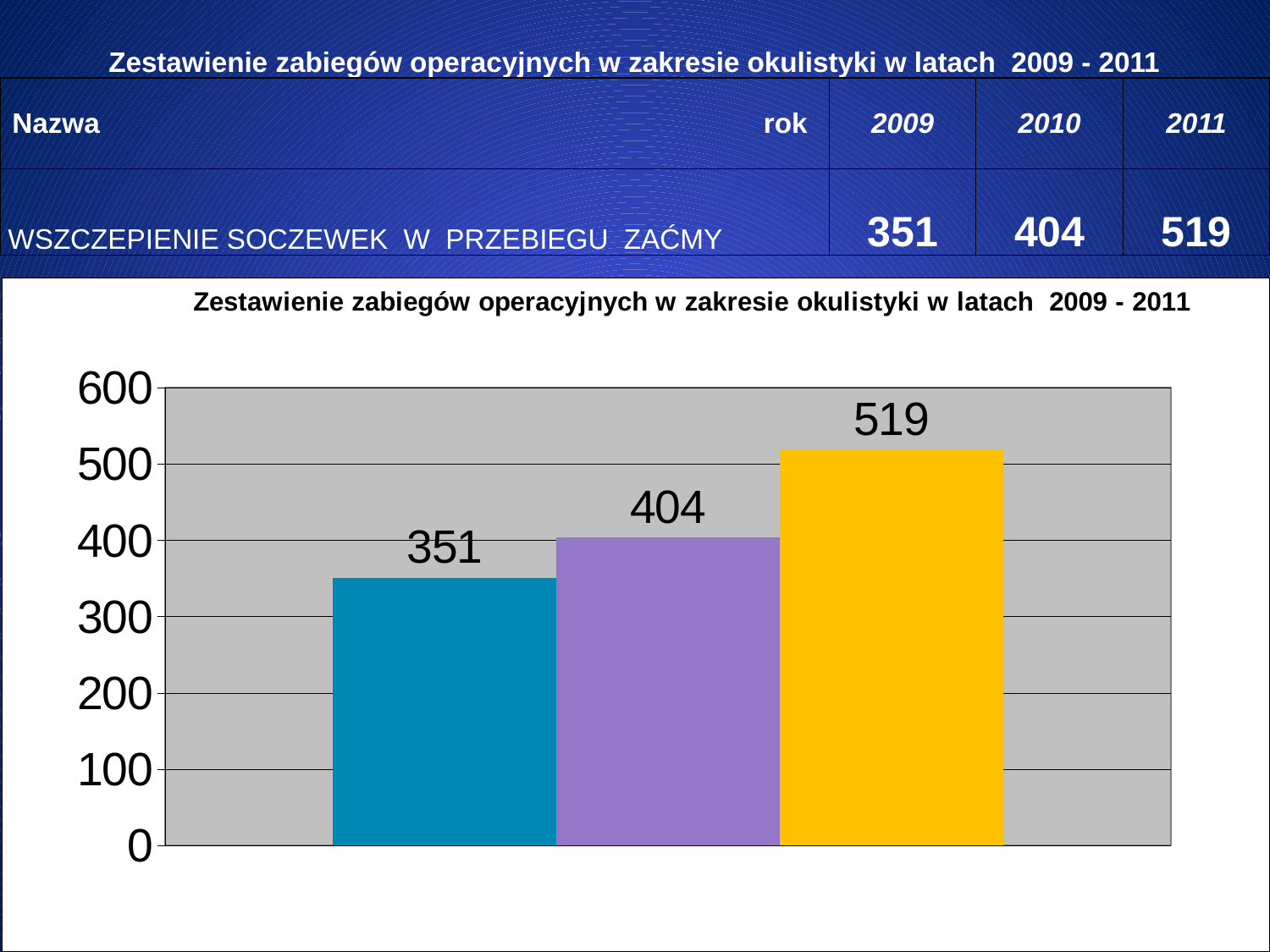
What is the difference between the purple bar (404) and the blue bar (351)? 53 How many bars are plotted in the chart? 3 What is the value shown on the first (blue) bar of the chart? 351 What is the difference between the yellow bar (519) and the blue bar (351)? 168 What type of chart is shown on the slide? bar chart What is the title of the chart? Zestawienie zabiegów operacyjnych w zakresie okulistyki w latach 2009 - 2011 What is the value shown on the middle (purple) bar of the chart? 404 According to the slide, how many lens implantation procedures (WSZCZEPIENIE SOCZEWEK W PRZEBIEGU ZAĆMY) were performed in 2011? 519 What is the value shown on the yellow bar of the chart? 519 Do the bar values rise or fall from left to right across the chart? rise Which bar in the chart has the lowest value? the blue bar (351) Which bar in the chart has the highest value? the yellow bar (519)